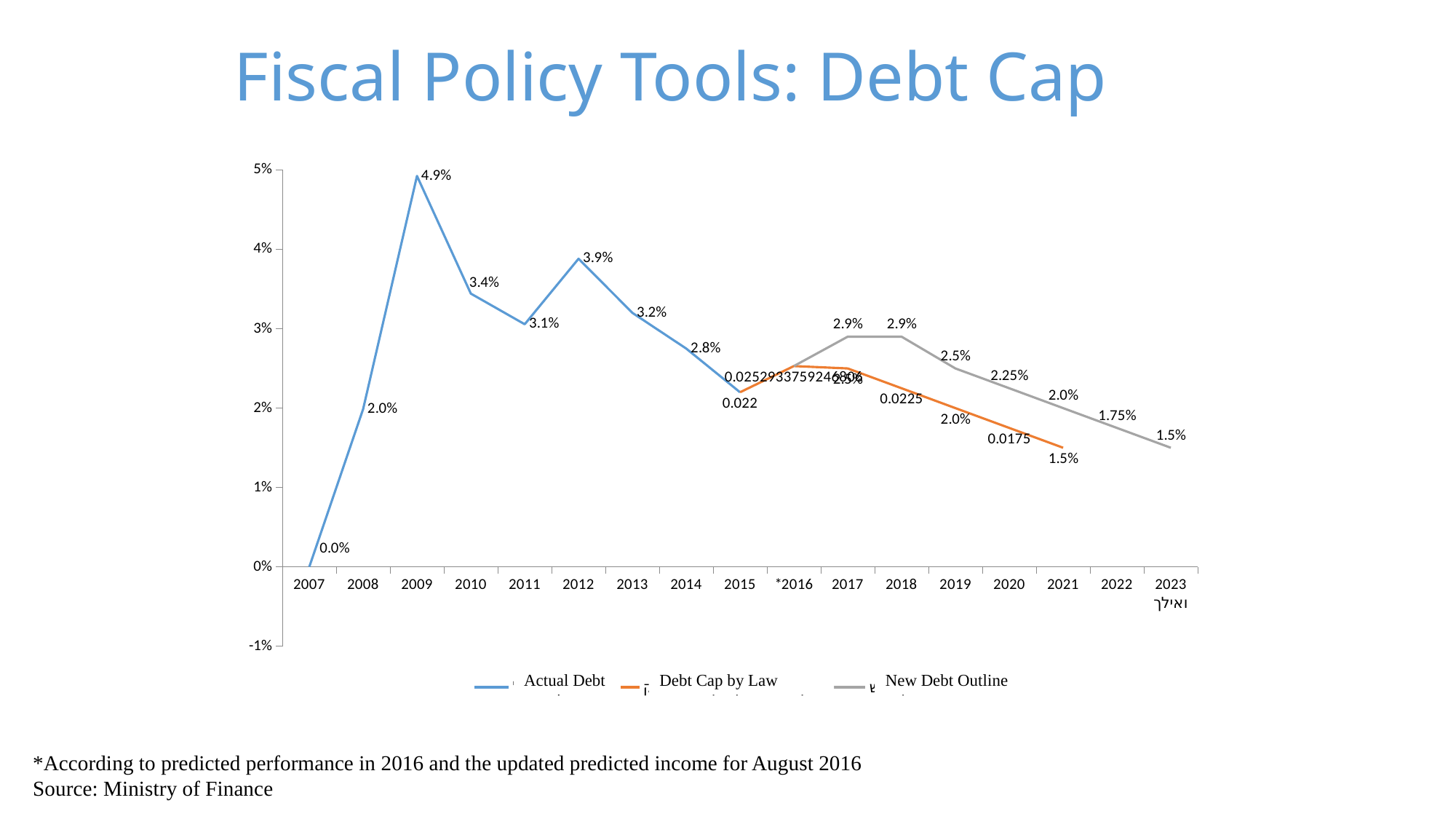
What is the Actual Debt value for 2012? 3.9% What is the New Debt Outline value for 2020? 2.25% What is the Debt Cap by Law value for 2021? 1.5% How many series does the legend list? 3 In which year does the Actual Debt series reach its highest value? 2009 Which is larger, the Actual Debt value for 2012 or for 2013? 2012 What is the Actual Debt value for 2009? 4.9% Does the New Debt Outline series rise or fall from 2018 to 2023? fall Is the Actual Debt value for 2015 greater or less than 3%? less In which year is the Actual Debt series at its lowest value? 2007 What type of chart is shown on the slide? line chart What is the difference between the Actual Debt values for 2009 and 2010? 1.5 percentage points